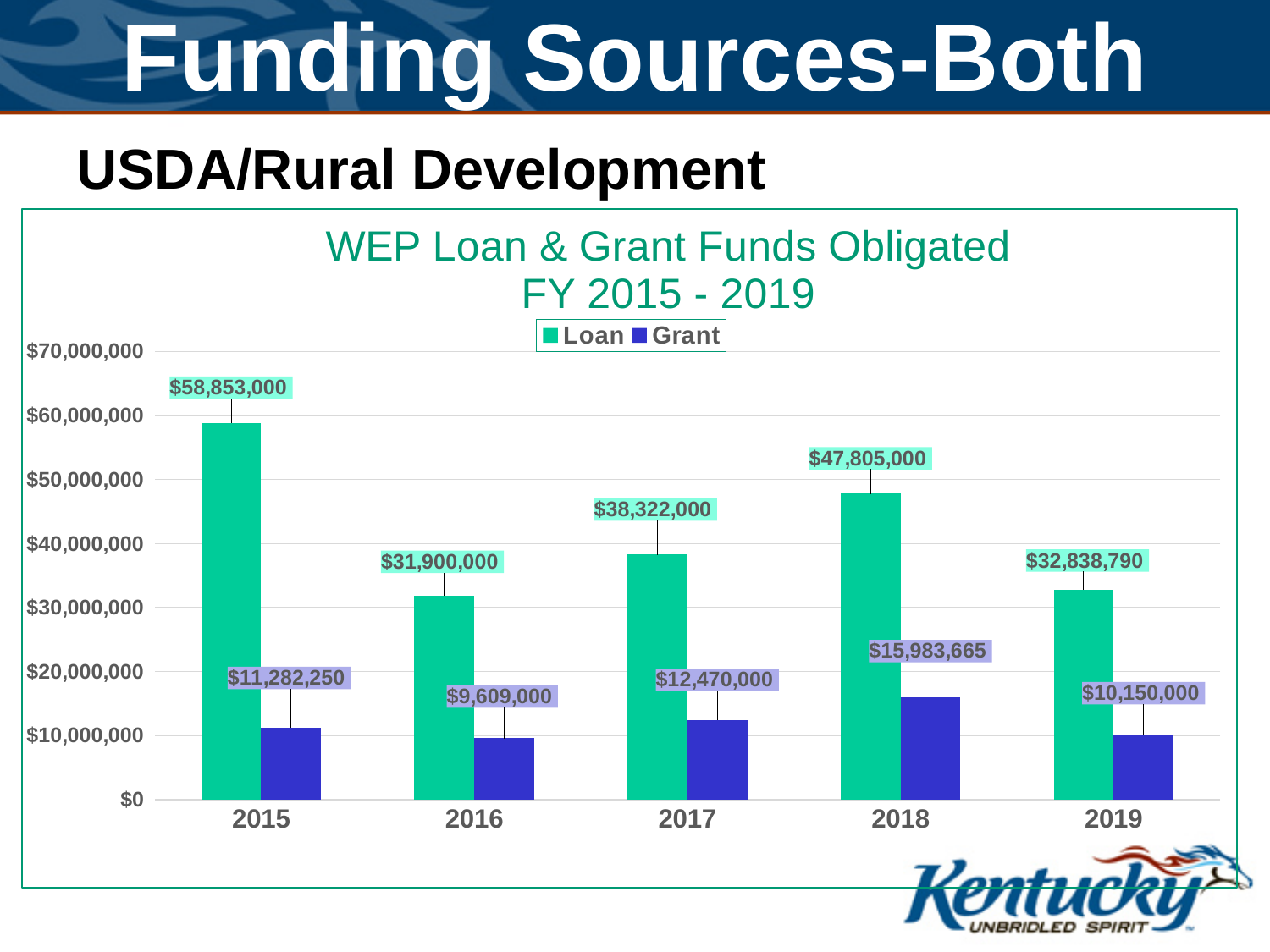
How many fiscal years are shown on the x axis? 5 Which fiscal year had the highest Grant amount? 2018 What was the Loan amount obligated in FY 2019? $32,838,790 What was the Grant amount obligated in FY 2018? $15,983,665 Which is larger, the Loan amount in FY 2016 or the Loan amount in FY 2019? FY 2019 How much larger was the Loan amount in FY 2018 than in FY 2017? $9,483,000 How many series does the legend list? 2 Which fiscal year had the highest Loan amount? 2015 What type of chart is shown on the slide? Bar chart What was the Loan amount obligated in FY 2015? $58,853,000 Which fiscal year had the lowest Grant amount? 2016 What is the difference between the Loan and Grant amounts in FY 2015? $47,570,750